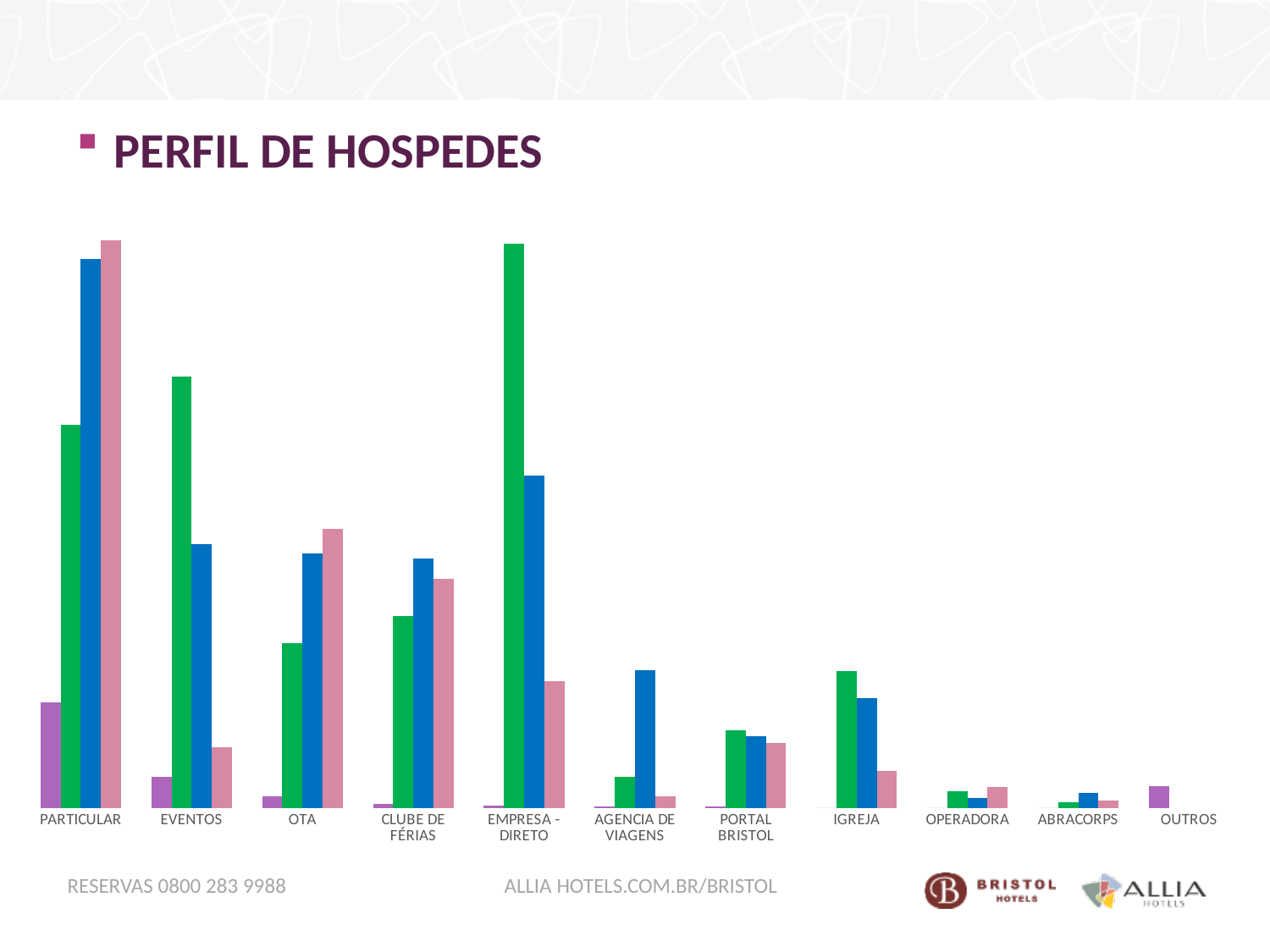
For OTA, which is larger, the pink bar or the green bar? pink bar Which category has the tallest pink bar? PARTICULAR For IGREJA, which is larger, the green bar or the pink bar? green bar What is the title of the chart on the slide? PERFIL DE HOSPEDES How many differently coloured bars are shown for each category? 4 For AGENCIA DE VIAGENS, which is larger, the blue bar or the green bar? blue bar How many categories are shown along the x axis of the chart? 11 Which category has the tallest green bar? EMPRESA - DIRETO Which category has the tallest purple bar? PARTICULAR What kind of chart is shown on the slide? bar chart